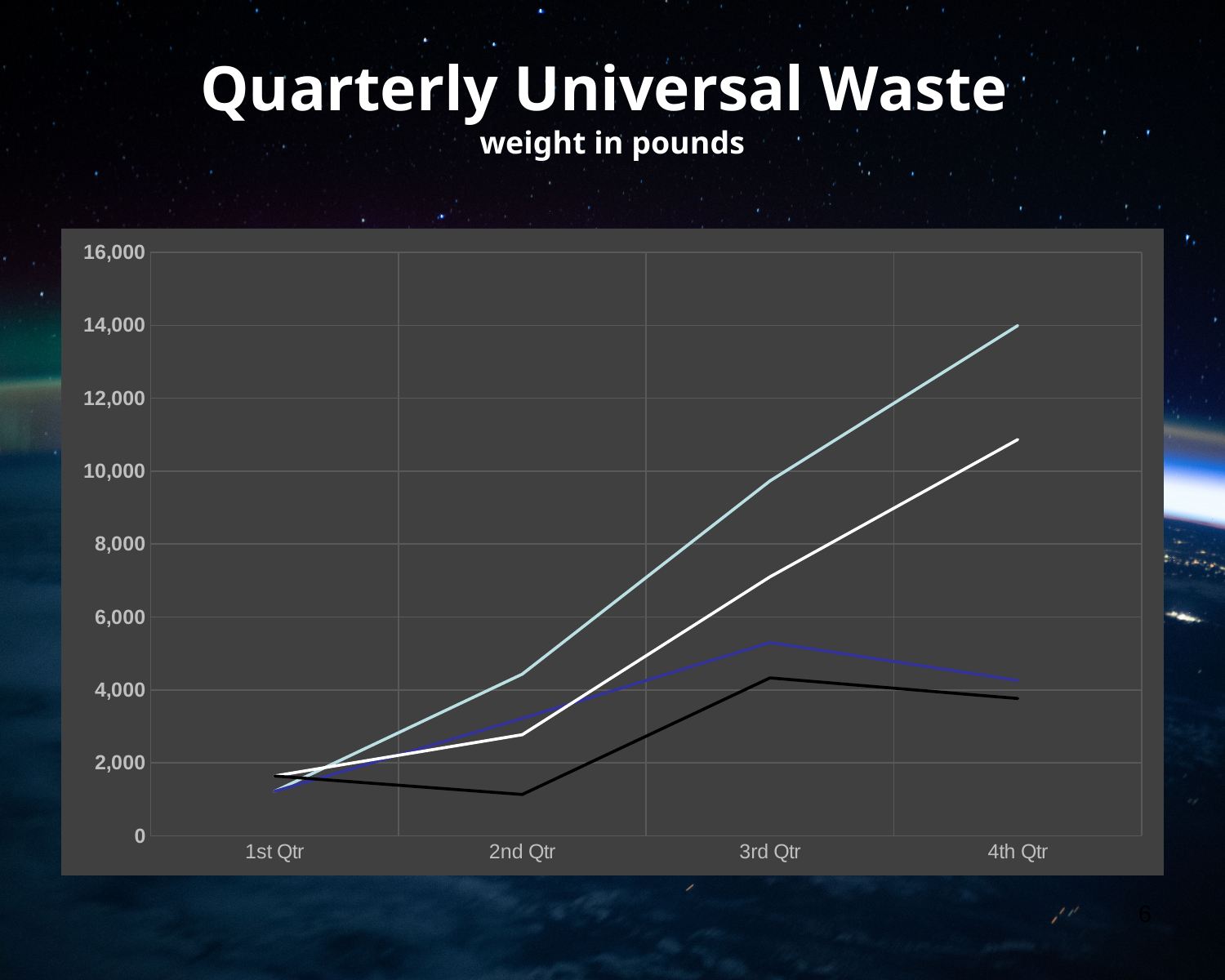
Is the value of the white line at 4th Qtr greater or less than 10,000? greater At 4th Qtr, which line has the larger value, the light blue line or the white line? light blue line How many quarters are shown on the x axis of the chart? 4 What kind of chart is shown on the slide? line chart Is the value of the light blue line at 4th Qtr greater or less than 12,000? greater According to the slide subtitle, in what unit is the waste weight measured? pounds Is the value of the black line at 2nd Qtr greater or less than 2,000? less In which quarter does the blue line reach its highest value? 3rd Qtr Does the light blue line rise or fall from 1st Qtr to 4th Qtr? rise How many lines are plotted on the chart? 4